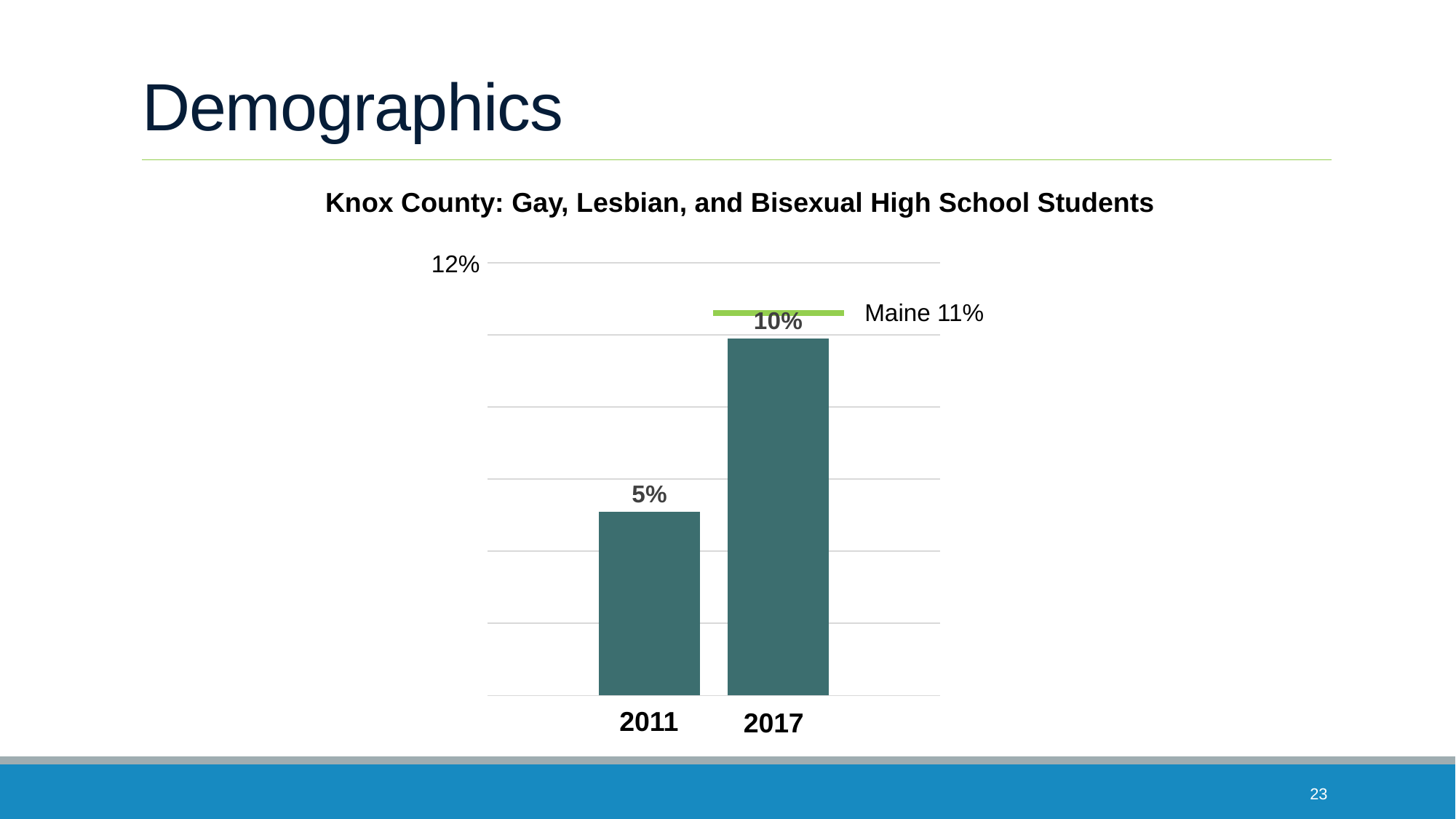
Which year has the lowest value? 2011 What kind of chart is this? bar chart What is the value for 2011? 5% Do the values rise or fall from 2011 to 2017? rise What is the title of the chart? Knox County: Gay, Lesbian, and Bisexual High School Students What is the difference between the 2017 and 2011 values? 5% Which is larger, the value for 2011 or the value for 2017? 2017 What is the highest value shown on the vertical axis? 12% How many years are shown on the chart? 2 What is the Maine value marked by the green line? 11% Which year has the highest value? 2017 What is the value for 2017? 10%